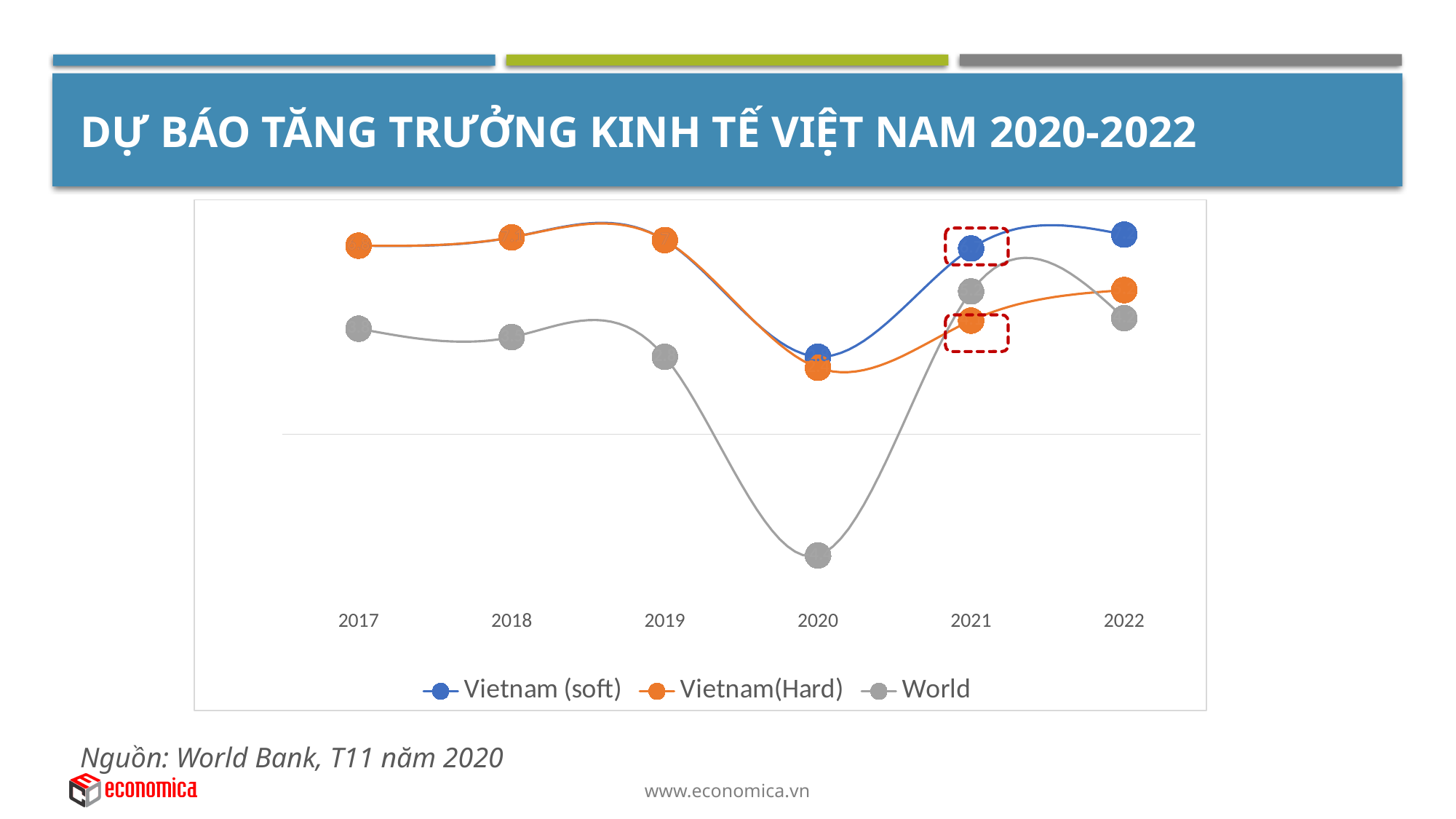
In which year is the World series at its highest? 2021 What kind of chart is shown on the slide? line chart In which year is the World series at its lowest? 2020 In 2020, which is higher: Vietnam (soft) or World? Vietnam (soft) Does the World series rise or fall from 2019 to 2020? fall In which year is the Vietnam(Hard) series at its lowest? 2020 How many years are shown on the x axis? 6 In which year is the Vietnam (soft) series at its lowest? 2020 Does the Vietnam (soft) series rise or fall from 2020 to 2022? rise How many series does the legend list? 3 In 2021, which is higher: Vietnam (soft) or Vietnam(Hard)? Vietnam (soft) What are the three series named in the legend? Vietnam (soft), Vietnam(Hard), World